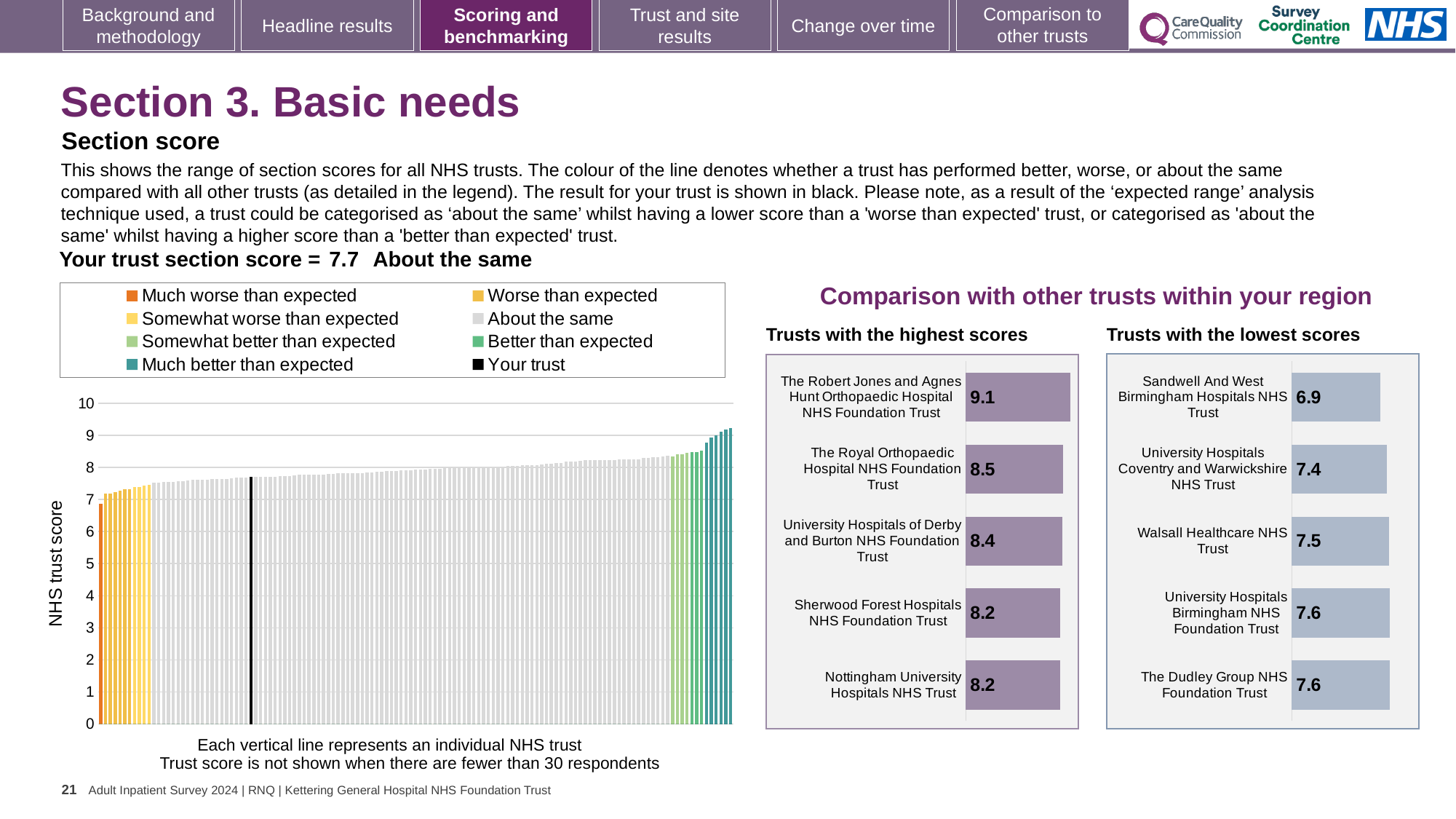
In the 'Trusts with the highest scores' chart, which trust has the highest score? The Robert Jones and Agnes Hunt Orthopaedic Hospital NHS Foundation Trust In the 'Trusts with the lowest scores' chart, which trust has the lowest score? Sandwell And West Birmingham Hospitals NHS Trust How many entries does the legend of the main chart on the left list? 8 In the 'Trusts with the highest scores' chart, what is the difference between the scores of The Robert Jones and Agnes Hunt Orthopaedic Hospital NHS Foundation Trust and The Royal Orthopaedic Hospital NHS Foundation Trust? 0.6 In the 'Trusts with the lowest scores' chart, how much higher is the score for University Hospitals Coventry and Warwickshire NHS Trust than for Sandwell And West Birmingham Hospitals NHS Trust? 0.5 What kind of chart is the 'Trusts with the highest scores' chart? bar chart How many trusts are shown in the 'Trusts with the highest scores' chart? 5 In the 'Trusts with the highest scores' chart, what is the score for The Robert Jones and Agnes Hunt Orthopaedic Hospital NHS Foundation Trust? 9.1 In the 'Trusts with the highest scores' chart, which has the higher score: University Hospitals of Derby and Burton NHS Foundation Trust or Sherwood Forest Hospitals NHS Foundation Trust? University Hospitals of Derby and Burton NHS Foundation Trust In the main chart of NHS trust scores on the left, what is the section score for your trust (shown in black)? 7.7 How many trusts are shown in the 'Trusts with the lowest scores' chart? 5 In the 'Trusts with the lowest scores' chart, what is the score for Walsall Healthcare NHS Trust? 7.5